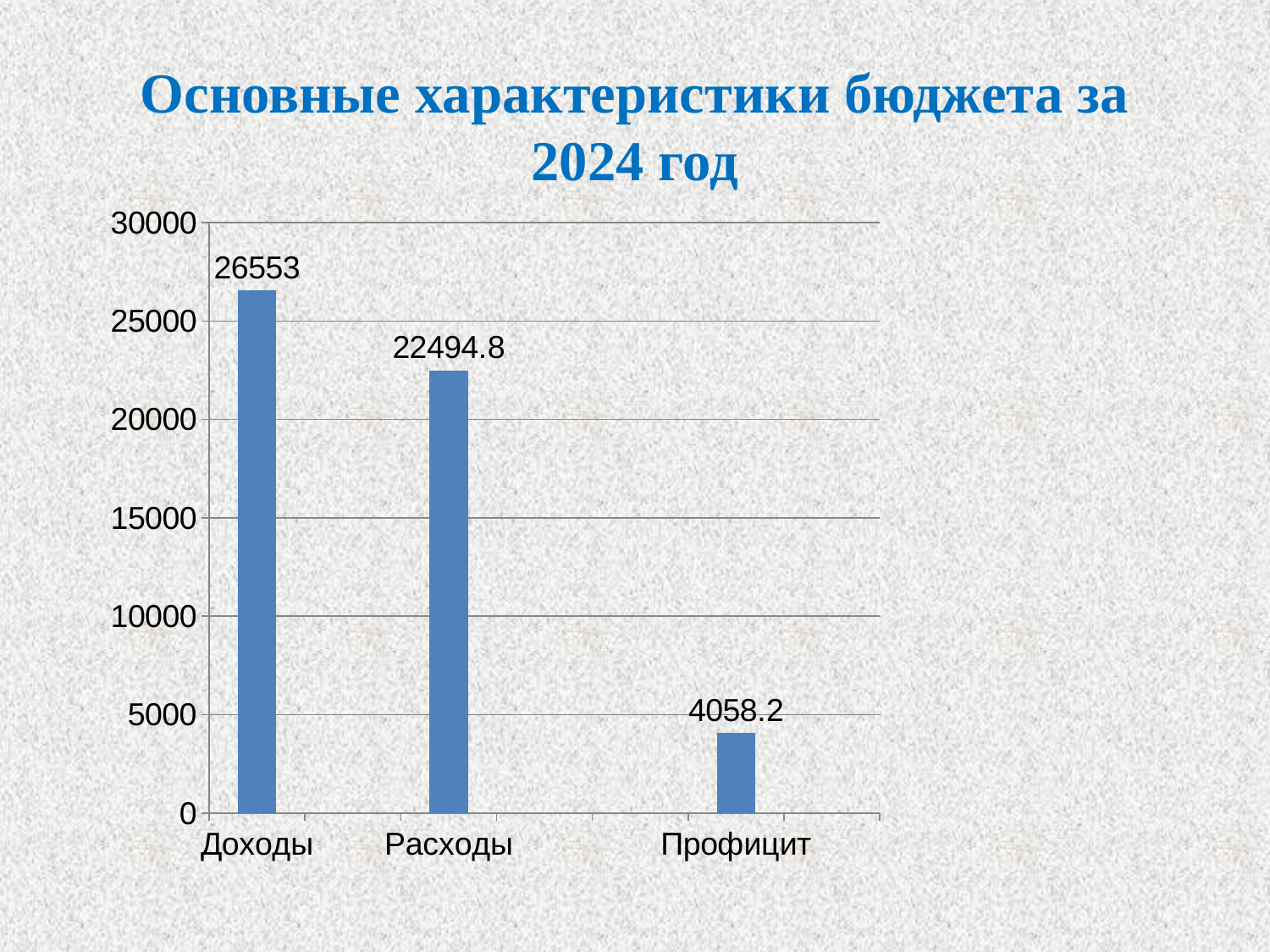
What kind of chart is shown on the slide? bar chart Is the value for Профицит greater or less than 5000? less What is the title of the slide? Основные характеристики бюджета за 2024 год Which category has the highest value? Доходы What is the value for Доходы? 26553 Which category has the lowest value? Профицит What is the difference between the values for Доходы and Расходы? 4058.2 Which is larger, the value for Доходы or the value for Расходы? Доходы What is the value for Расходы? 22494.8 How many categories are shown on the x axis? 3 What is the difference between the values for Расходы and Профицит? 18436.6 What is the value for Профицит? 4058.2